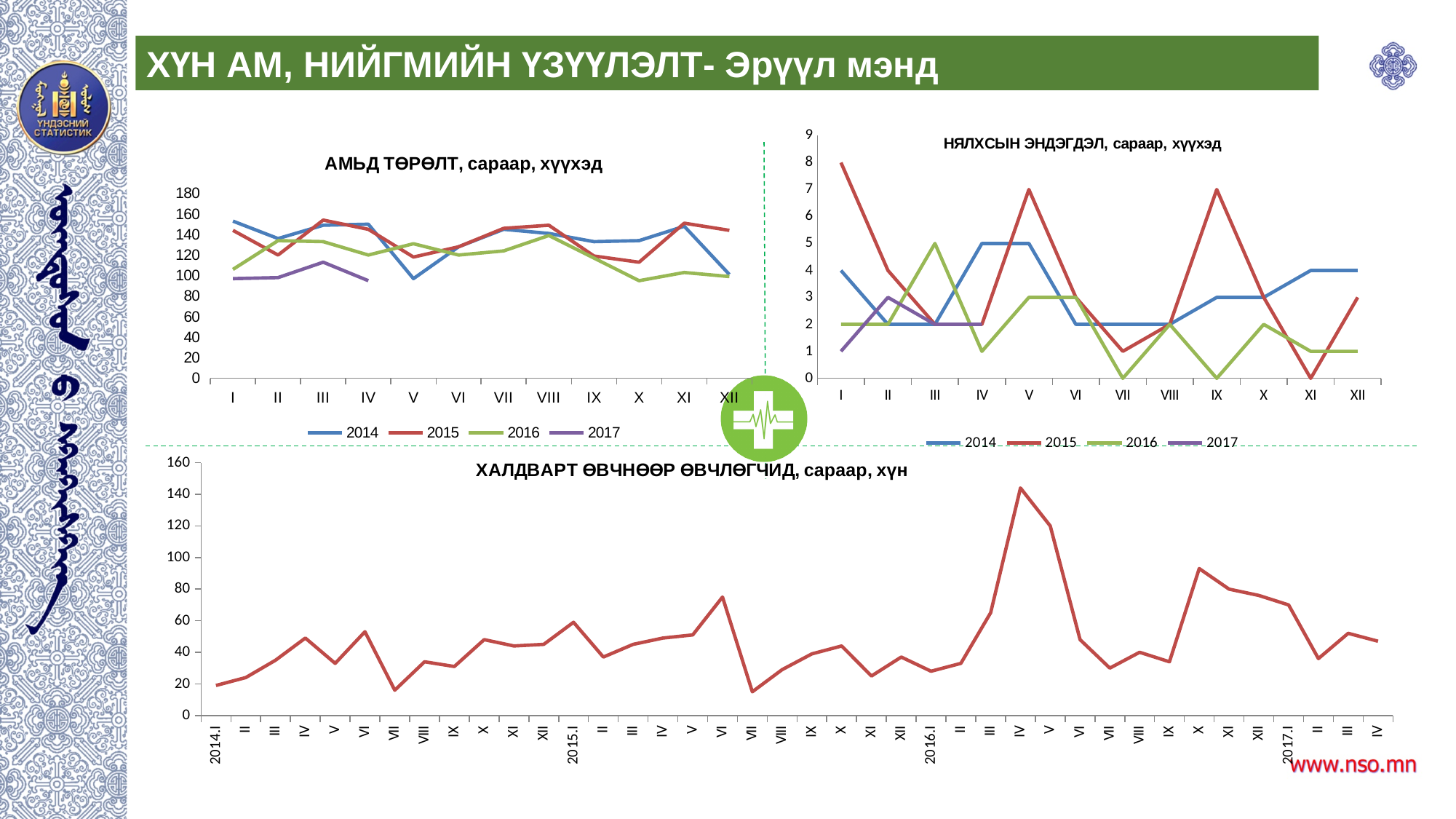
How many series does the legend of the 'АМЬД ТӨРӨЛТ, сараар, хүүхэд' chart list? 4 How many months are shown on the x axis of the 'АМЬД ТӨРӨЛТ, сараар, хүүхэд' chart? 12 In the 'НЯЛХСЫН ЭНДЭГДЭЛ, сараар, хүүхэд' chart, which month has the highest value for 2015? I In the 'НЯЛХСЫН ЭНДЭГДЭЛ, сараар, хүүхэд' chart, what is the difference between the 2015 and 2014 values in month I? 4 In the 'ХАЛДВАРТ ӨВЧНӨӨР ӨВЧЛӨГЧИД, сараар, хүн' chart, which month has the highest value? 2016.IV In the 'ХАЛДВАРТ ӨВЧНӨӨР ӨВЧЛӨГЧИД, сараар, хүн' chart, is the value for 2016.IV greater or less than 120? greater In the 'НЯЛХСЫН ЭНДЭГДЭЛ, сараар, хүүхэд' chart, what is the 2015 value for month I? 8 In the 'НЯЛХСЫН ЭНДЭГДЭЛ, сараар, хүүхэд' chart, which series has the larger value in month V, 2014 or 2015? 2015 What kind of chart is the 'АМЬД ТӨРӨЛТ, сараар, хүүхэд' chart? line chart In the 'НЯЛХСЫН ЭНДЭГДЭЛ, сараар, хүүхэд' chart, what is the 2016 value for month VII? 0 In the 'АМЬД ТӨРӨЛТ, сараар, хүүхэд' chart, is the 2015 value for month III greater or less than 140? greater In the 'НЯЛХСЫН ЭНДЭГДЭЛ, сараар, хүүхэд' chart, what is the 2014 value for month IV? 5